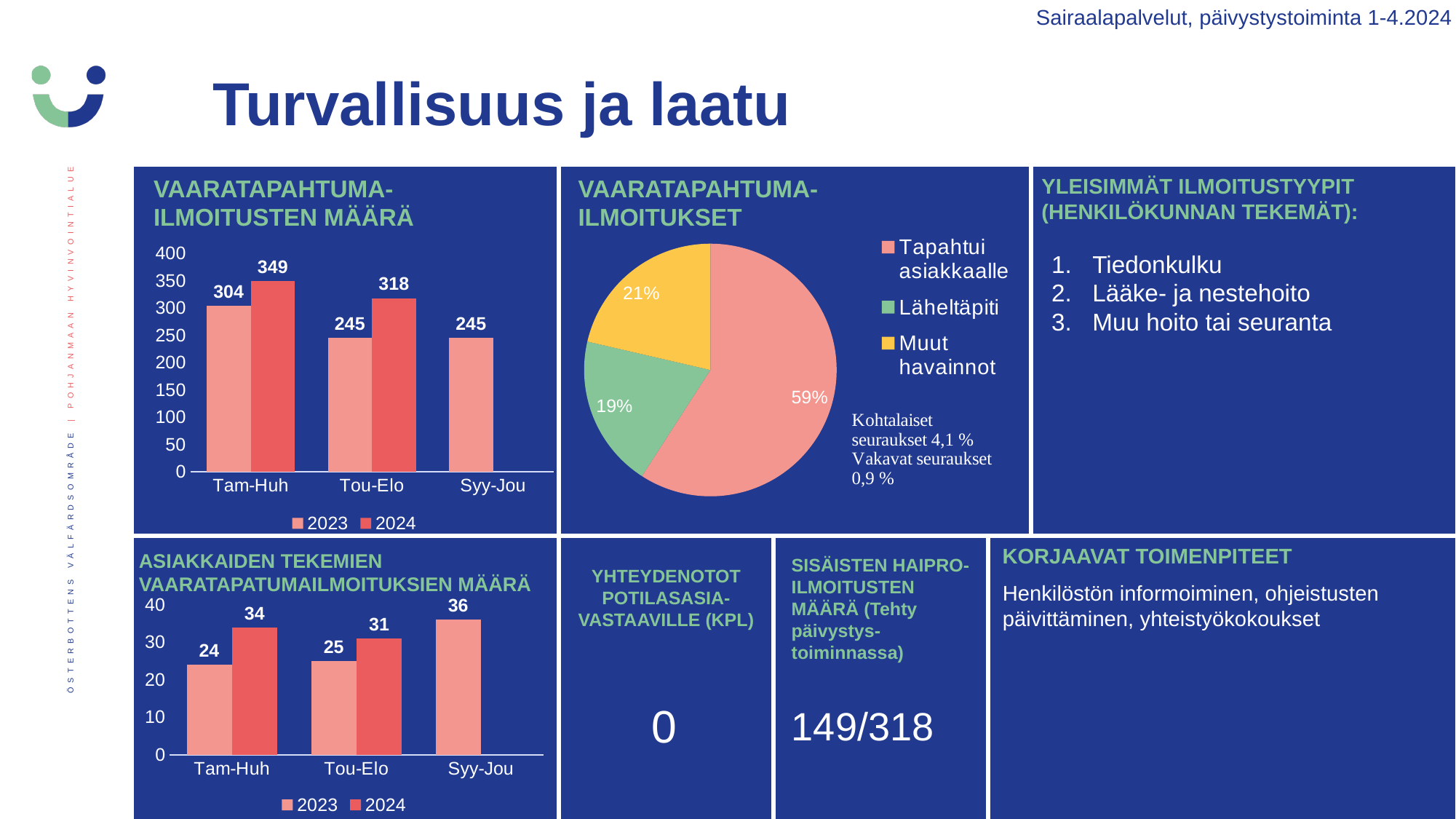
In the chart titled ASIAKKAIDEN TEKEMIEN VAARATAPATUMAILMOITUKSIEN MÄÄRÄ, which is larger: 2023 or 2024 in Tam-Huh? 2024 In the chart titled VAARATAPAHTUMA-ILMOITUSTEN MÄÄRÄ, what is the value for 2023 in Syy-Jou? 245 In the chart titled VAARATAPAHTUMA-ILMOITUSTEN MÄÄRÄ, how many series does the legend list? 2 What kind of chart is the one titled VAARATAPAHTUMA-ILMOITUKSET? pie chart In the chart titled ASIAKKAIDEN TEKEMIEN VAARATAPATUMAILMOITUKSIEN MÄÄRÄ, what is the difference between the 2024 and 2023 values for Tou-Elo? 6 In the chart titled VAARATAPAHTUMA-ILMOITUSTEN MÄÄRÄ, what is the value for 2024 in Tam-Huh? 349 In the pie chart titled VAARATAPAHTUMA-ILMOITUKSET, what share does Läheltäpiti have? 19% In the pie chart titled VAARATAPAHTUMA-ILMOITUKSET, how many slices are there? 3 In the chart titled VAARATAPAHTUMA-ILMOITUSTEN MÄÄRÄ, what is the difference between the 2024 and 2023 values for Tou-Elo? 73 In the chart titled VAARATAPAHTUMA-ILMOITUSTEN MÄÄRÄ, which category has the highest 2024 value? Tam-Huh In the pie chart titled VAARATAPAHTUMA-ILMOITUKSET, which slice is the largest? Tapahtui asiakkaalle In the chart titled ASIAKKAIDEN TEKEMIEN VAARATAPATUMAILMOITUKSIEN MÄÄRÄ, what is the value for 2023 in Syy-Jou? 36